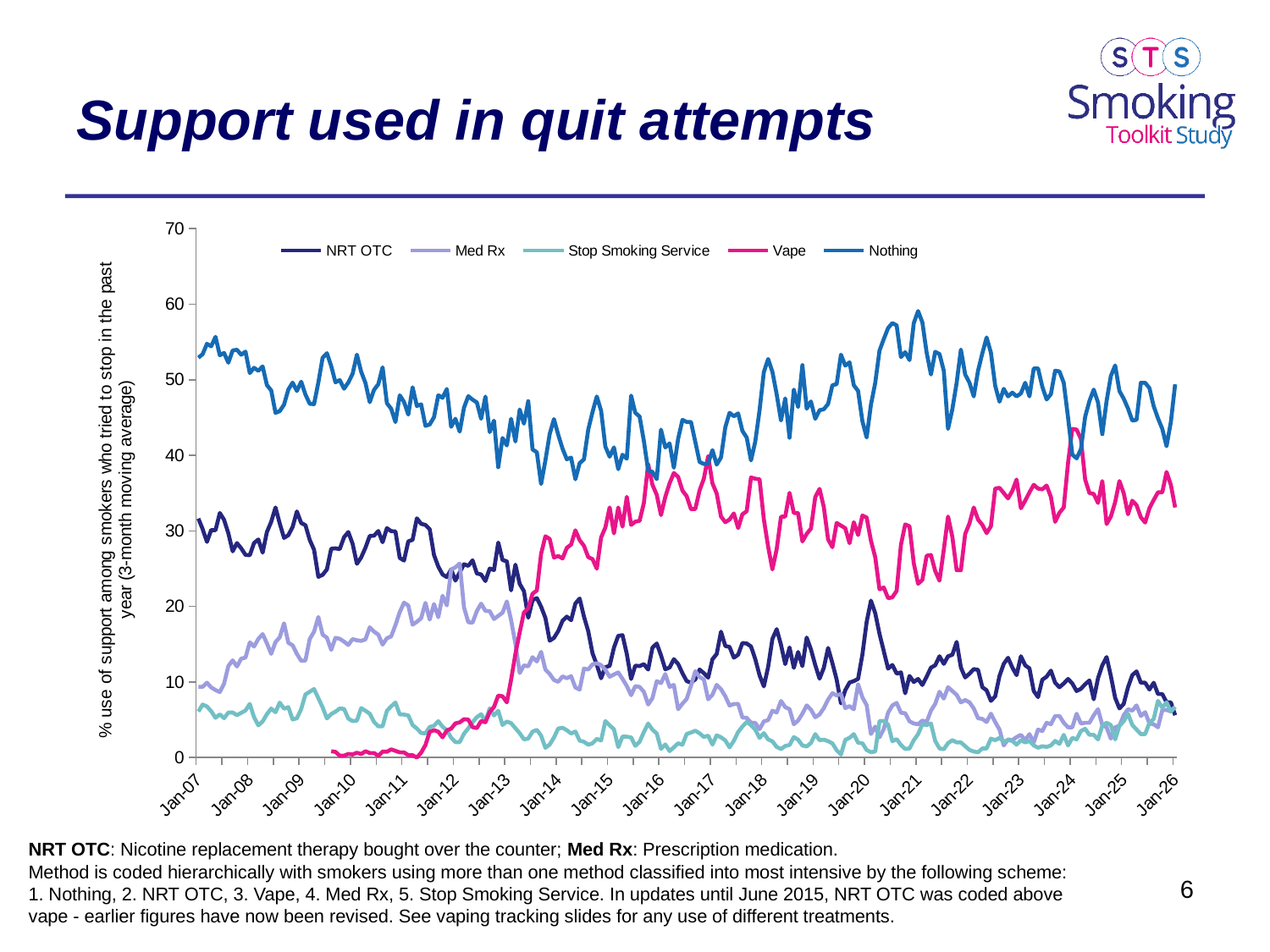
Is the value for Nothing at Jan-07 greater or less than 50? greater Which series has the lowest value around Jan-16? Stop Smoking Service Does the NRT OTC series rise or fall overall from Jan-07 to Jan-26? fall At Jan-18, which is larger: Vape or NRT OTC? Vape Which series has the highest values across the whole period shown? Nothing How many series does the legend list? 5 What is the title of the slide containing the chart? Support used in quit attempts Does the Vape series rise or fall between Jan-13 and Jan-16? rise At Jan-09, which is larger: NRT OTC or Med Rx? NRT OTC Is the value for Nothing at Jan-21 greater or less than 50? greater What kind of chart is shown on the slide? line chart Is the value for Vape at Jan-10 greater or less than 10? less